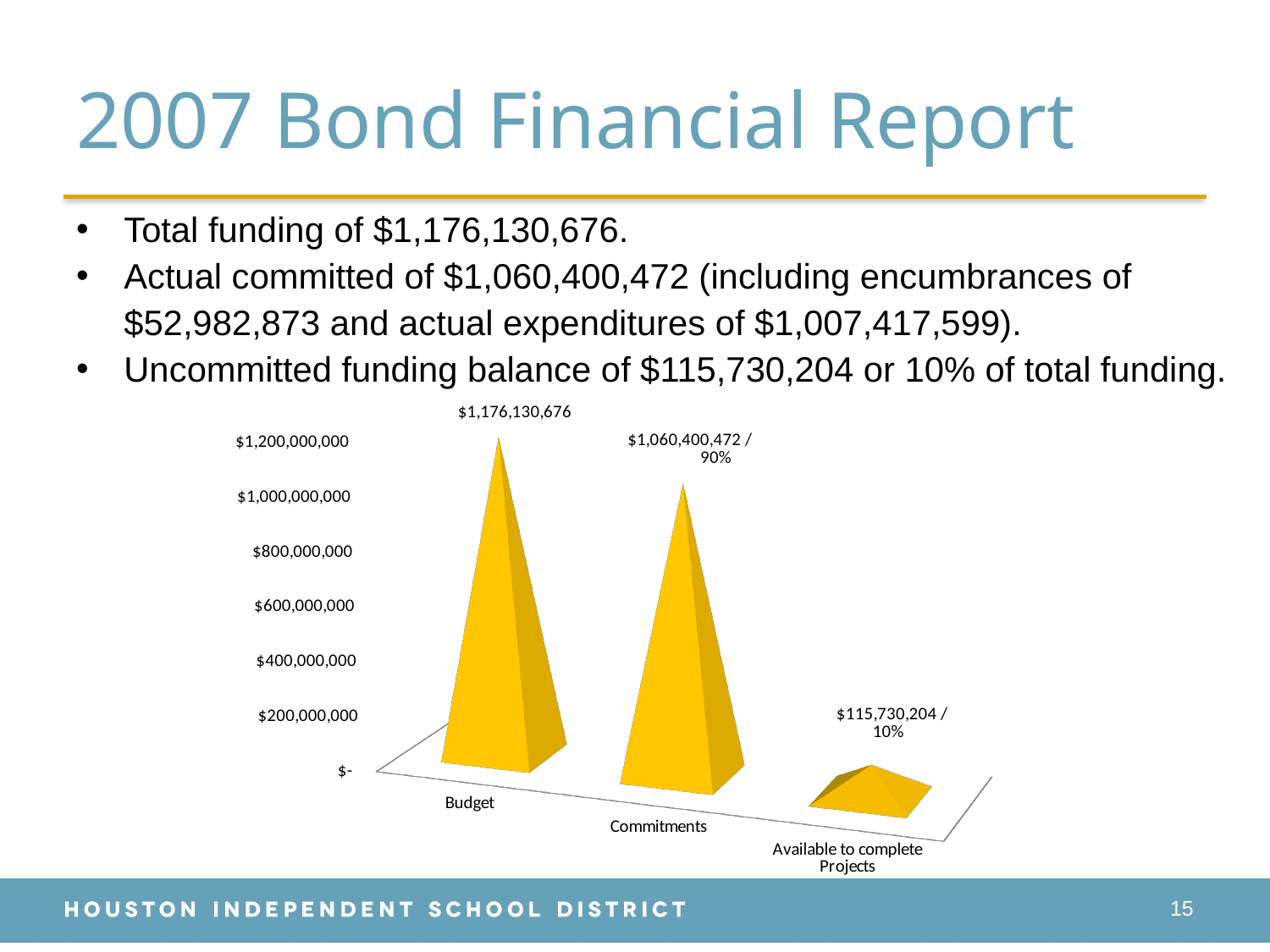
Is the value for Available to complete Projects greater or less than $200,000,000? less What is the value shown for Budget? $1,176,130,676 How many categories are shown on the chart? 3 Which category has the lowest value? Available to complete Projects What percentage is shown next to the Commitments value? 90% What is the difference between the Budget value and the Commitments value? $115,730,204 Which is larger, the value for Commitments or the value for Available to complete Projects? Commitments What is the value shown for Available to complete Projects? $115,730,204 What is the difference between the Commitments value and the Available to complete Projects value? $944,670,268 What percentage is shown next to the Available to complete Projects value? 10% Which category has the highest value? Budget What is the value shown for Commitments? $1,060,400,472